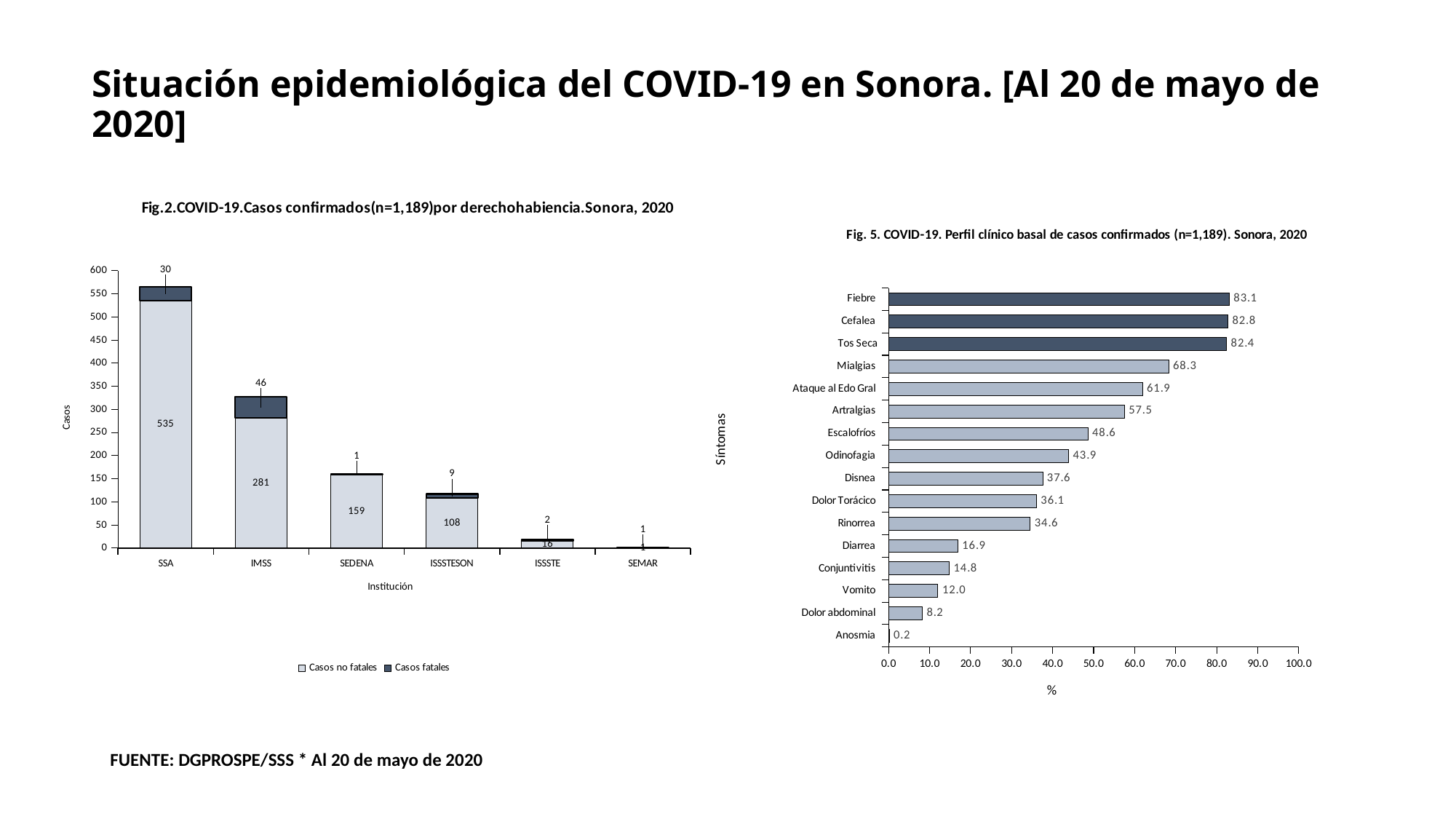
In Fig. 5 (Perfil clínico basal), how many symptoms are listed on the y axis? 16 In Fig. 2 (Casos confirmados por derechohabiencia), what is the total number of cases (fatal plus non-fatal) for ISSSTESON? 117 In Fig. 2 (Casos confirmados por derechohabiencia), how many non-fatal cases (Casos no fatales) are shown for SSA? 535 In Fig. 5 (Perfil clínico basal), which is larger, the value for Disnea or the value for Rinorrea? Disnea In Fig. 2 (Casos confirmados por derechohabiencia), what is the difference between the non-fatal cases of SSA and IMSS? 254 In Fig. 2 (Casos confirmados por derechohabiencia), how many series does the legend list? 2 In Fig. 5 (Perfil clínico basal), what percentage is shown for Fiebre? 83.1 In Fig. 2 (Casos confirmados por derechohabiencia), how many institutions are shown on the x axis? 6 In Fig. 2 (Casos confirmados por derechohabiencia), how many fatal cases (Casos fatales) are shown for IMSS? 46 What type of chart is Fig. 5 (Perfil clínico basal)? Bar chart In Fig. 5 (Perfil clínico basal), which symptom has the lowest percentage? Anosmia In Fig. 2 (Casos confirmados por derechohabiencia), which institution has the highest number of non-fatal cases? SSA